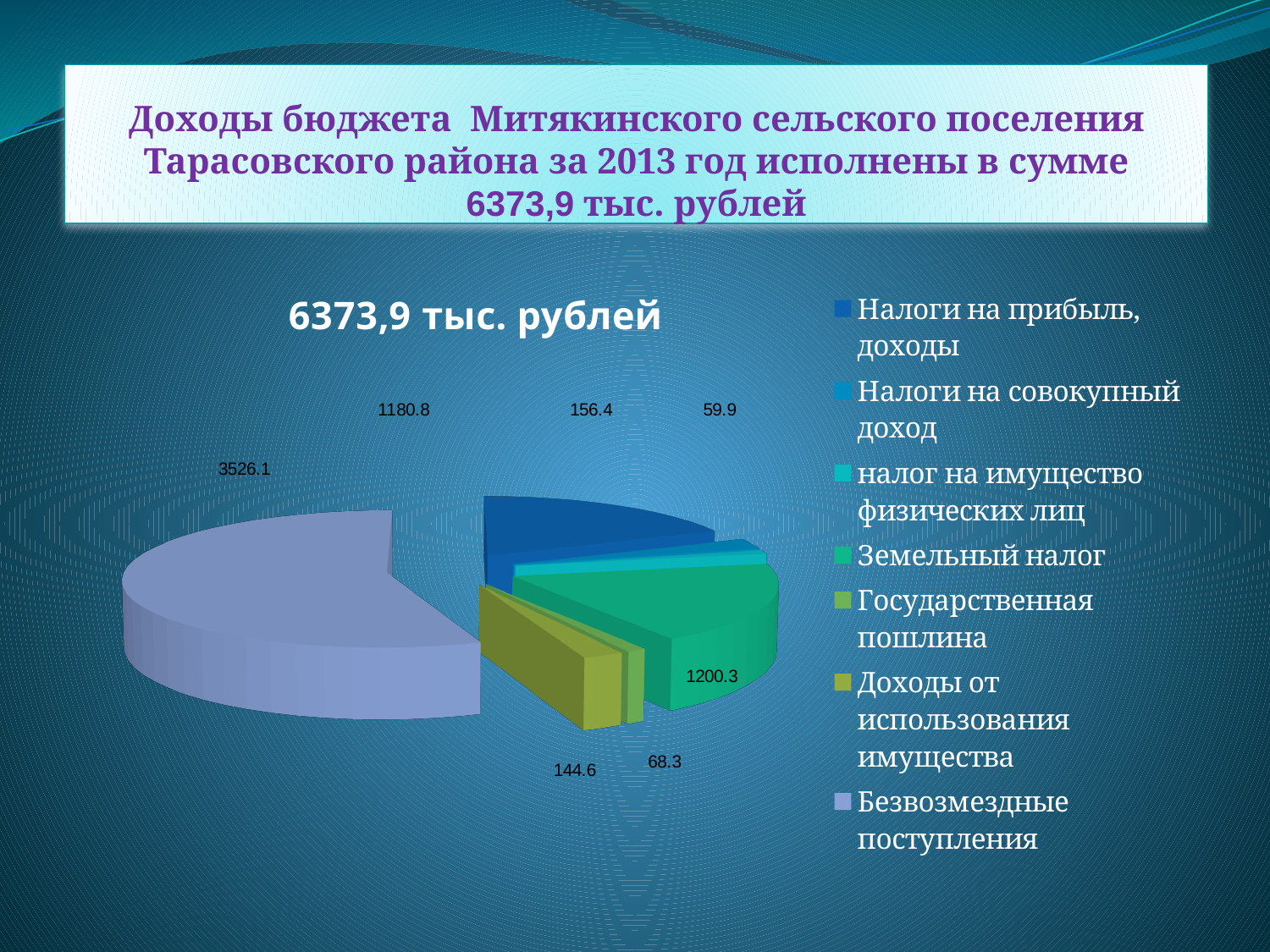
What is the difference between Безвозмездные поступления and Земельный налог? 2325.8 How many categories does the legend list? 7 What is the value for Доходы от использования имущества? 144.6 Which category has the smallest slice of the pie? налог на имущество физических лиц What is the value for Налоги на прибыль, доходы? 1180.8 What is the value for Налоги на совокупный доход? 156.4 What is the value for Земельный налог? 1200.3 What kind of chart is shown on the slide? pie chart What is the title of the chart? 6373,9 тыс. рублей What is the value for Безвозмездные поступления? 3526.1 Which category has the largest slice of the pie? Безвозмездные поступления Which is larger, Земельный налог or Налоги на прибыль, доходы? Земельный налог